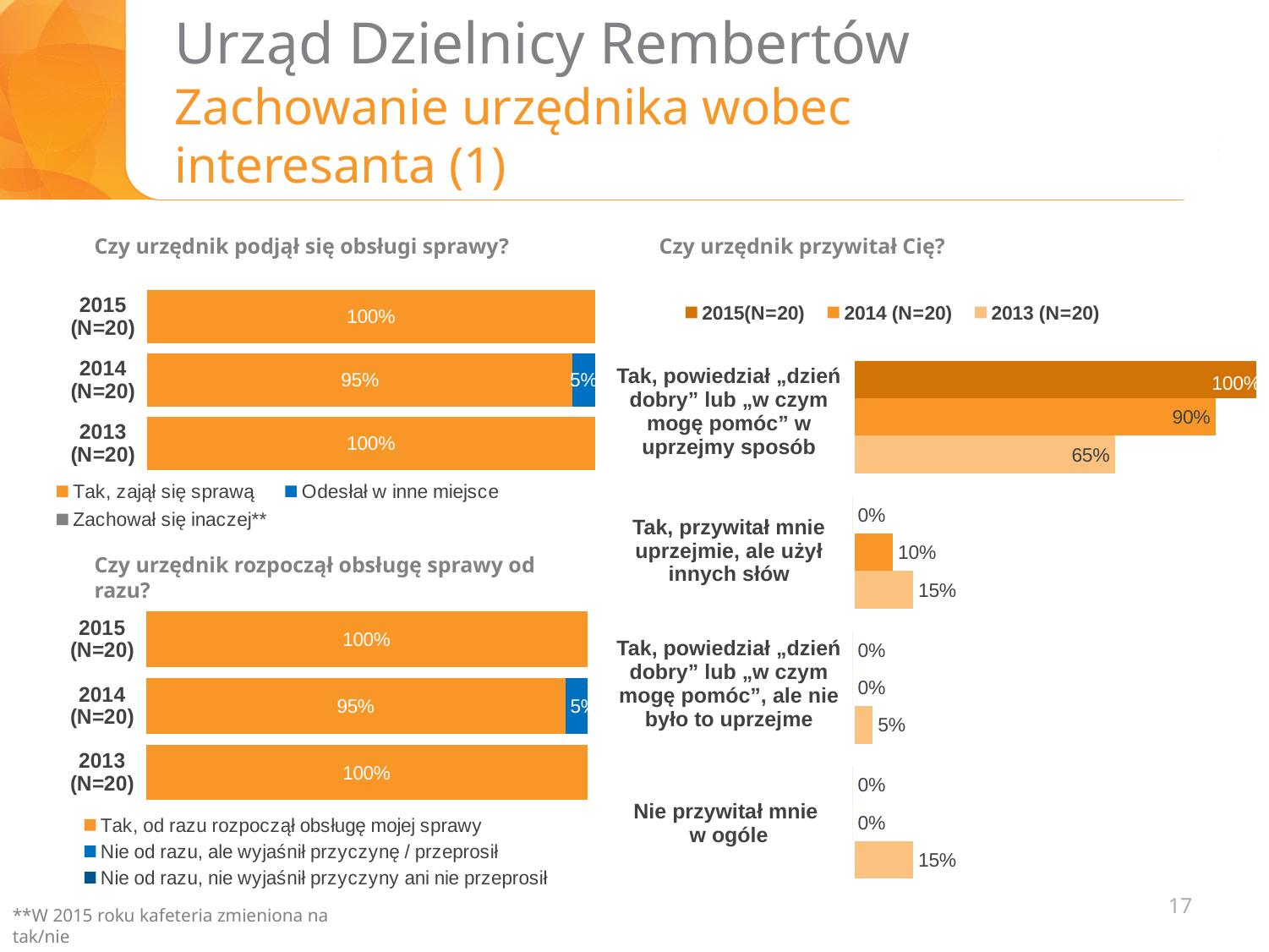
In the chart "Czy urzędnik rozpoczął obsługę sprawy od razu?", what is the value for 2015 (N=20)? 100% What type of chart is "Czy urzędnik rozpoczął obsługę sprawy od razu?"? Bar chart In the chart "Czy urzędnik podjął się obsługi sprawy?", what is the "Odesłał w inne miejsce" value for 2014 (N=20)? 5% How many series does the legend of the chart "Czy urzędnik przywitał Cię?" list? 3 How many answer categories are shown in the chart "Czy urzędnik przywitał Cię?"? 4 In the chart "Czy urzędnik przywitał Cię?", what is the 2013 (N=20) value for "Nie przywitał mnie w ogóle"? 15% In the chart "Czy urzędnik przywitał Cię?", which year has the highest value for "Tak, powiedział „dzień dobry” lub „w czym mogę pomóc” w uprzejmy sposób"? 2015 (N=20) In the chart "Czy urzędnik przywitał Cię?", what is the 2013 (N=20) value for "Tak, powiedział „dzień dobry” lub „w czym mogę pomóc” w uprzejmy sposób"? 65% In the chart "Czy urzędnik podjął się obsługi sprawy?", what is the "Tak, zajął się sprawą" value for 2014 (N=20)? 95% In the chart "Czy urzędnik przywitał Cię?", which is larger for "Tak, przywitał mnie uprzejmie, ale użył innych słów": the 2014 value or the 2013 value? 2013 (N=20) In the chart "Czy urzędnik przywitał Cię?", what is the 2014 (N=20) value for "Tak, powiedział „dzień dobry” lub „w czym mogę pomóc” w uprzejmy sposób"? 90% In the chart "Czy urzędnik przywitał Cię?", what is the difference between the 2015 and 2013 values for "Tak, powiedział „dzień dobry” lub „w czym mogę pomóc” w uprzejmy sposób"? 35 percentage points